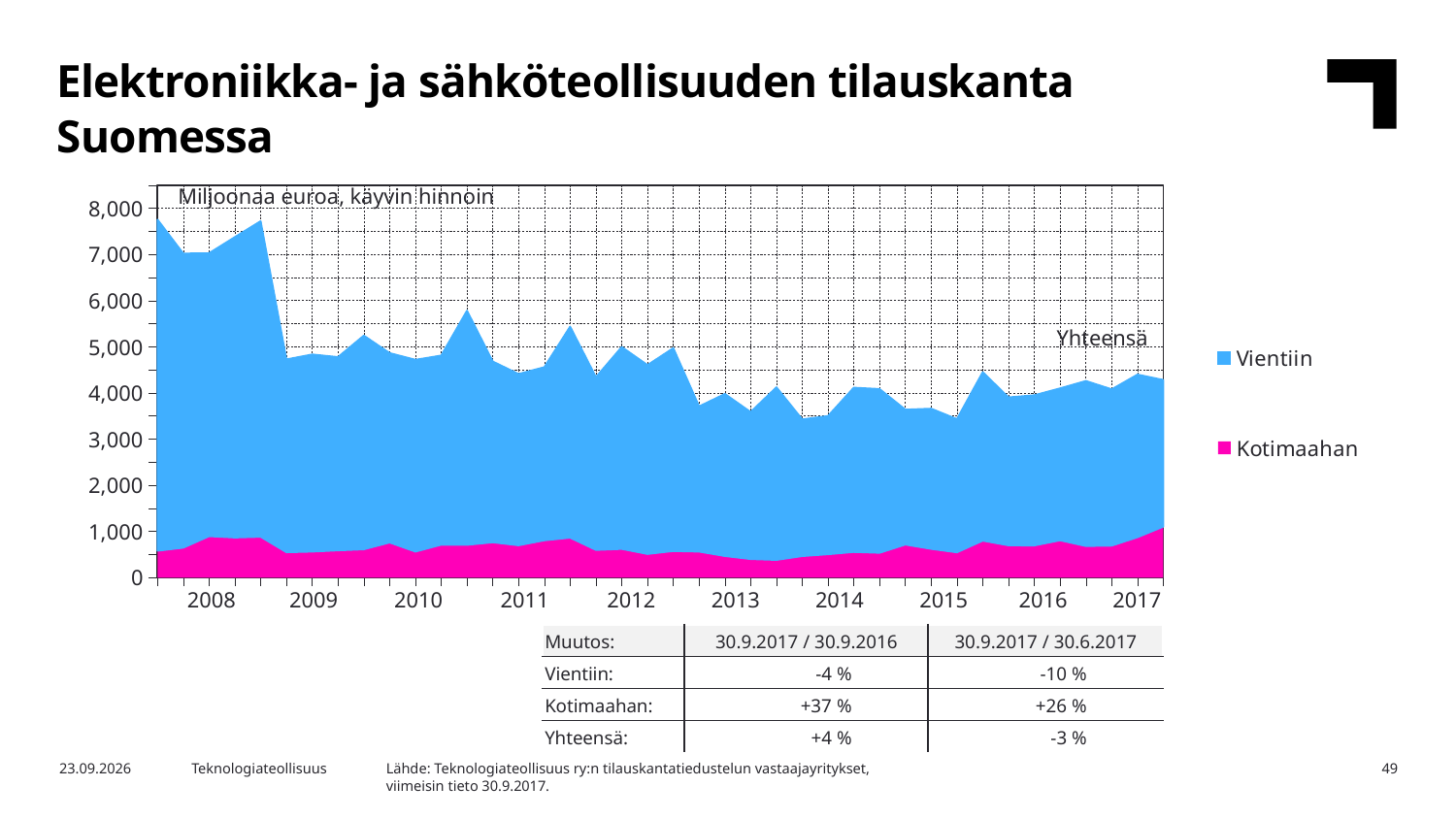
What unit is stated at the top of the chart? Miljoonaa euroa, käyvin hinnoin Is the total (Yhteensä) value in 2014 greater or less than 5,000? less How many years are labelled on the x axis? 10 Is the total order book larger in 2008 or in 2017? 2008 Is the Kotimaahan value in 2013 greater or less than 1,000? less Is the total (Yhteensä) value at the start of 2008 greater or less than 7,000? greater In which year does the total order book reach its highest level? 2008 What are the two series named in the legend? Vientiin and Kotimaahan Does the total order book overall rise or fall from 2008 to 2017? Fall What kind of chart is shown on the slide? Stacked area chart How many series does the legend list? 2